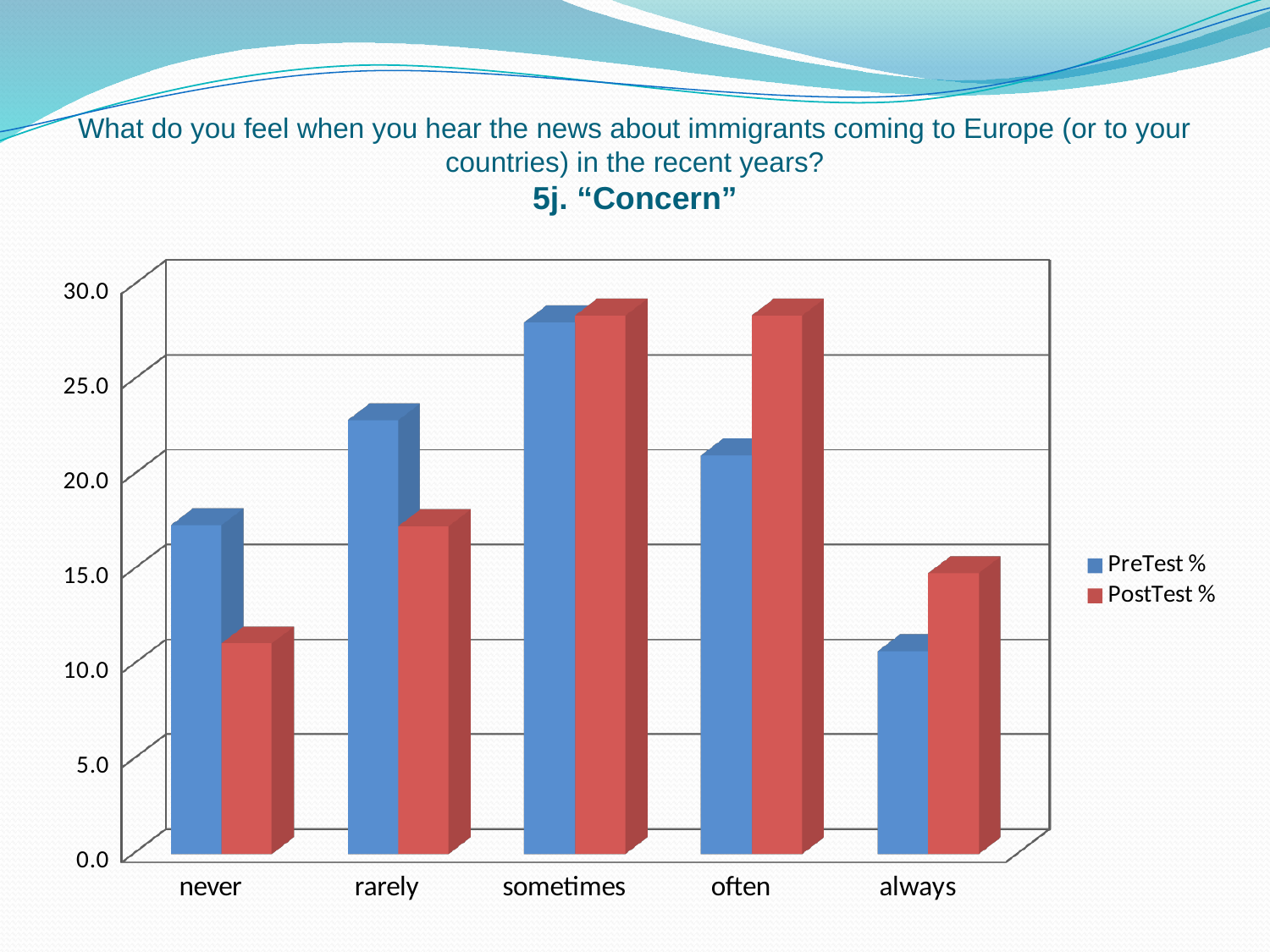
Which category has the lowest PostTest % value? never How many series does the legend list? 2 How many categories are shown on the x axis? 5 Which series is shown in red in the legend? PostTest % Is the PostTest % value for "sometimes" greater or less than 25.0? greater For the category "often", which is larger: PreTest % or PostTest %? PostTest % Which category has the highest PreTest % value? sometimes For the category "never", which is larger: PreTest % or PostTest %? PreTest % Which category has the lowest PreTest % value? always What kind of chart is shown on the slide? bar chart Is the PreTest % value for "rarely" greater or less than 20.0? greater For the category "always", which is larger: PreTest % or PostTest %? PostTest %